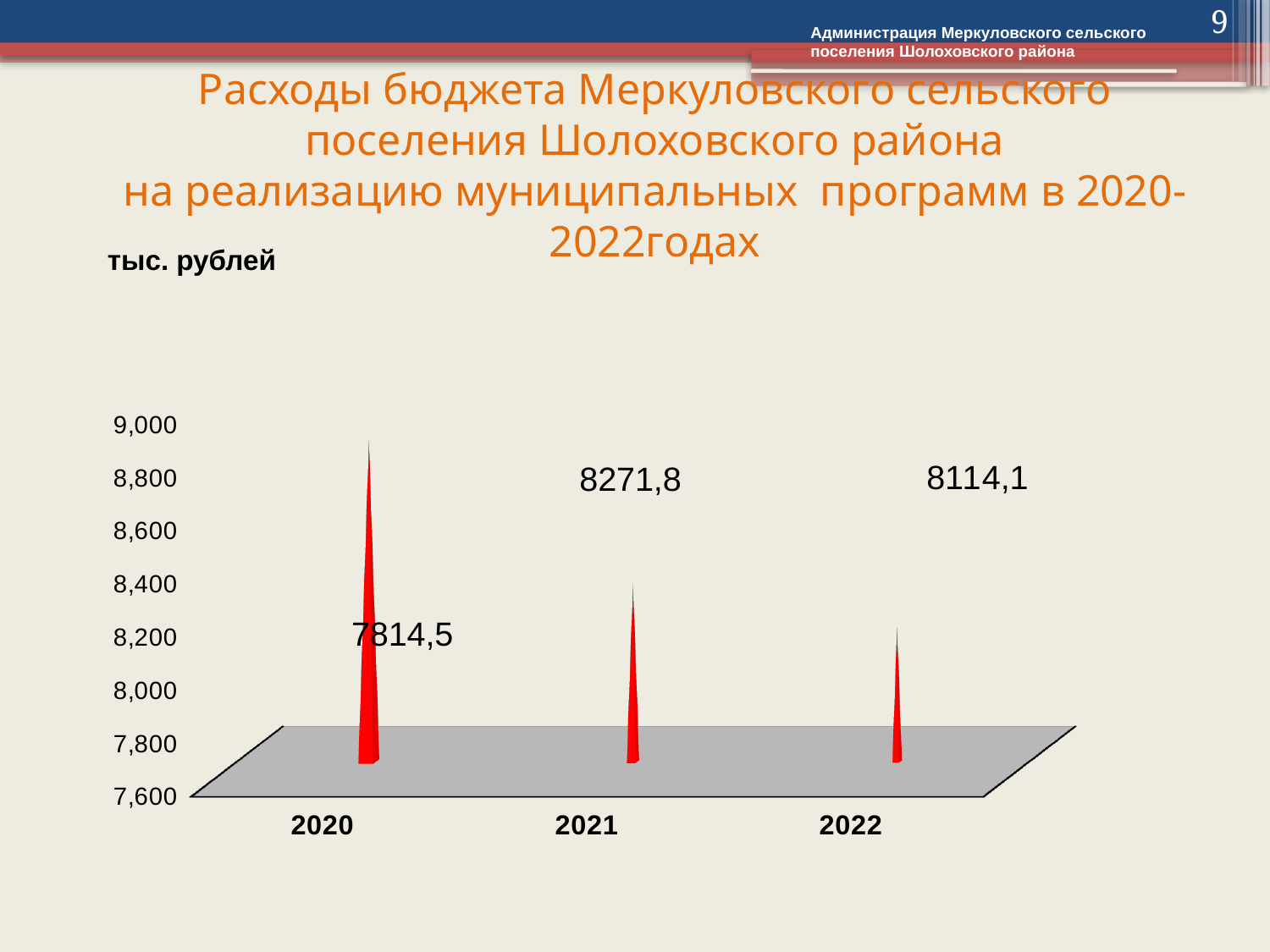
What kind of chart is shown on the slide? bar chart What is the difference between the labelled values for 2021 and 2020? 457,3 What is the lowest value shown on the vertical axis? 7,600 What is the value shown for 2021? 8271,8 What is the value shown for 2022? 8114,1 What is the difference between the labelled values for 2021 and 2022? 157,7 What is the value shown for 2020? 7814,5 How many years are plotted on the chart? 3 What is the difference between the labelled values for 2022 and 2020? 299,6 In what unit are the values on the chart expressed? тыс. рублей Which is larger according to the data labels, the value for 2021 or the value for 2022? 2021